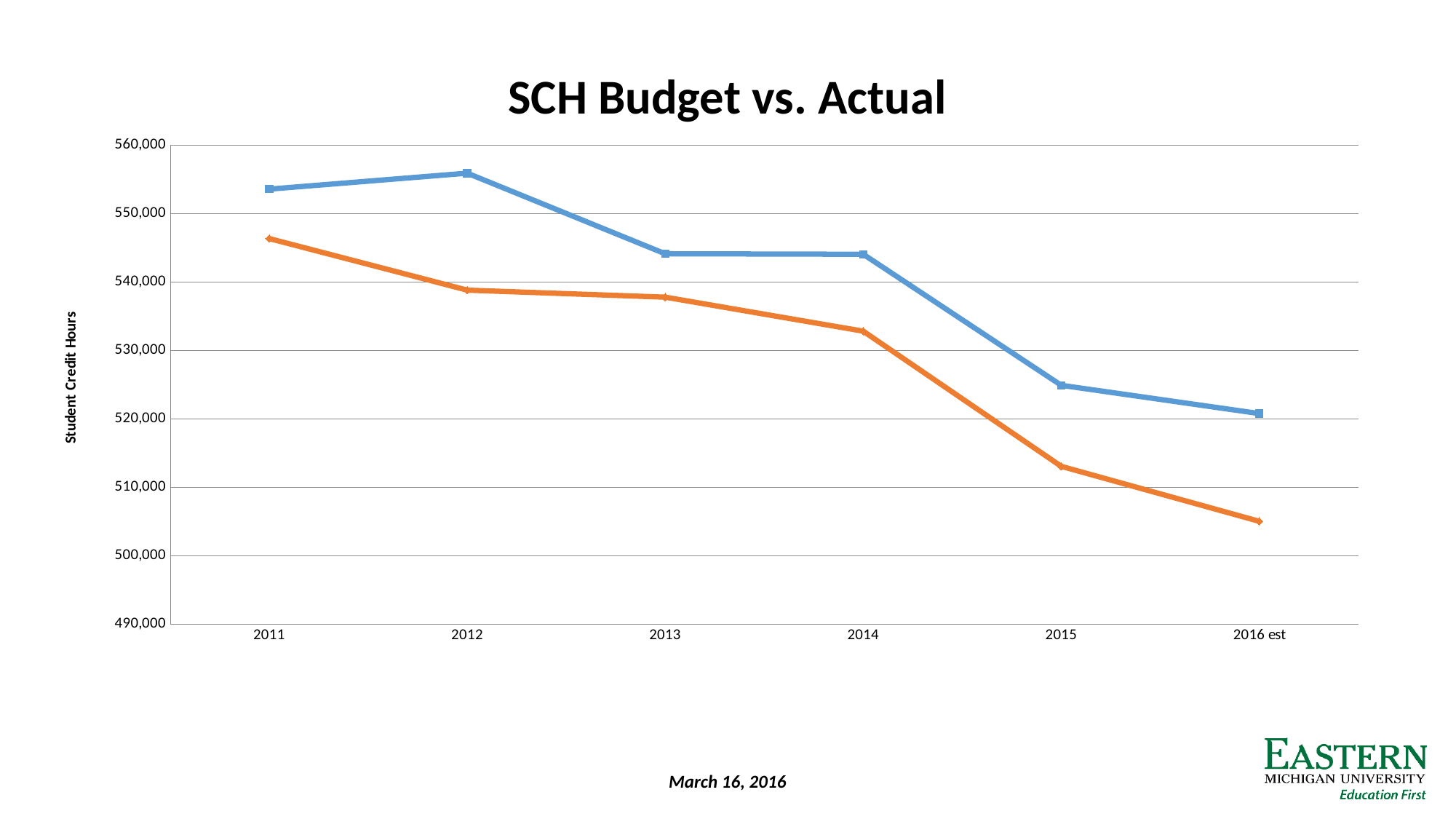
What is the label of the vertical axis? Student Credit Hours In which year does the blue line reach its highest value? 2012 In 2015, which line has the larger value, the blue line or the orange line? the blue line How many years are shown along the x axis of the chart? 6 What kind of chart is shown on the slide? line chart In which year does the orange line reach its highest value? 2011 What is the title of the chart? SCH Budget vs. Actual In which year does the orange line reach its lowest value? 2016 est Is the value of the orange line in 2016 est greater or less than 510,000? less Is the value of the blue line in 2013 greater or less than 550,000? less Do the values of the orange line rise or fall from 2011 to 2016 est? fall Is the value of the blue line in 2011 greater or less than 550,000? greater